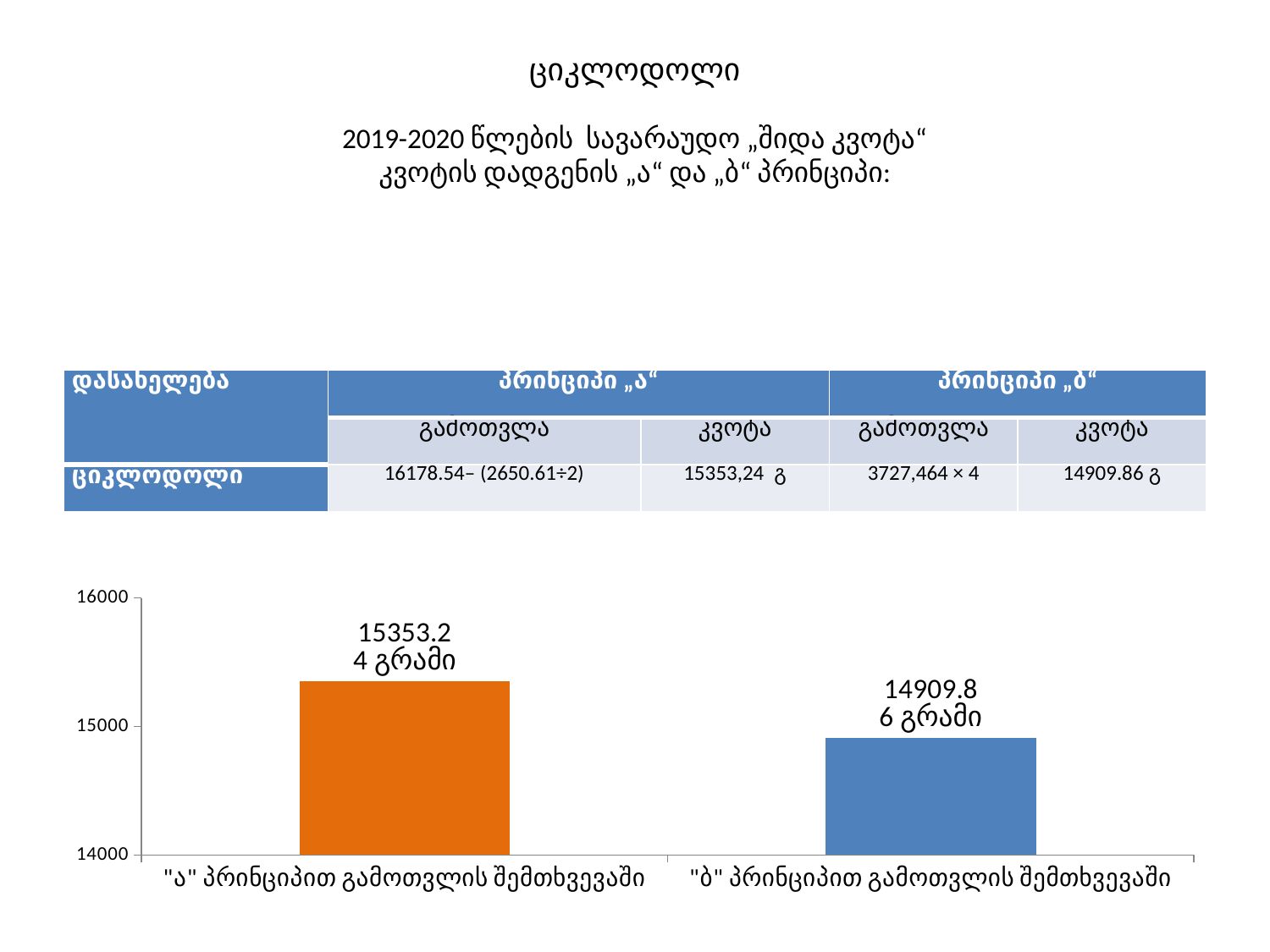
Which category has the higher value? "ა" პრინციპით გამოთვლის შემთხვევაში What is the value shown for "ა" პრინციპით გამოთვლის შემთხვევაში? 15353.24 გრამი Is the value for principle "ა" larger or smaller than the value for principle "ბ"? larger What type of chart is shown on the slide? bar chart Which category has the lower value? "ბ" პრინციპით გამოთვლის შემთხვევაში Is the value for "ბ" პრინციპით გამოთვლის შემთხვევაში greater or less than 15000? less What colour is the bar for "ა" პრინციპით გამოთვლის შემთხვევაში? orange What is the value shown for "ბ" პრინციპით გამოთვლის შემთხვევაში? 14909.86 გრამი What is the difference between the values for principle "ა" and principle "ბ"? 443.38 What is the lowest value shown on the vertical axis? 14000 Is the value for "ა" პრინციპით გამოთვლის შემთხვევაში greater or less than 15000? greater How many bars does the chart have? 2